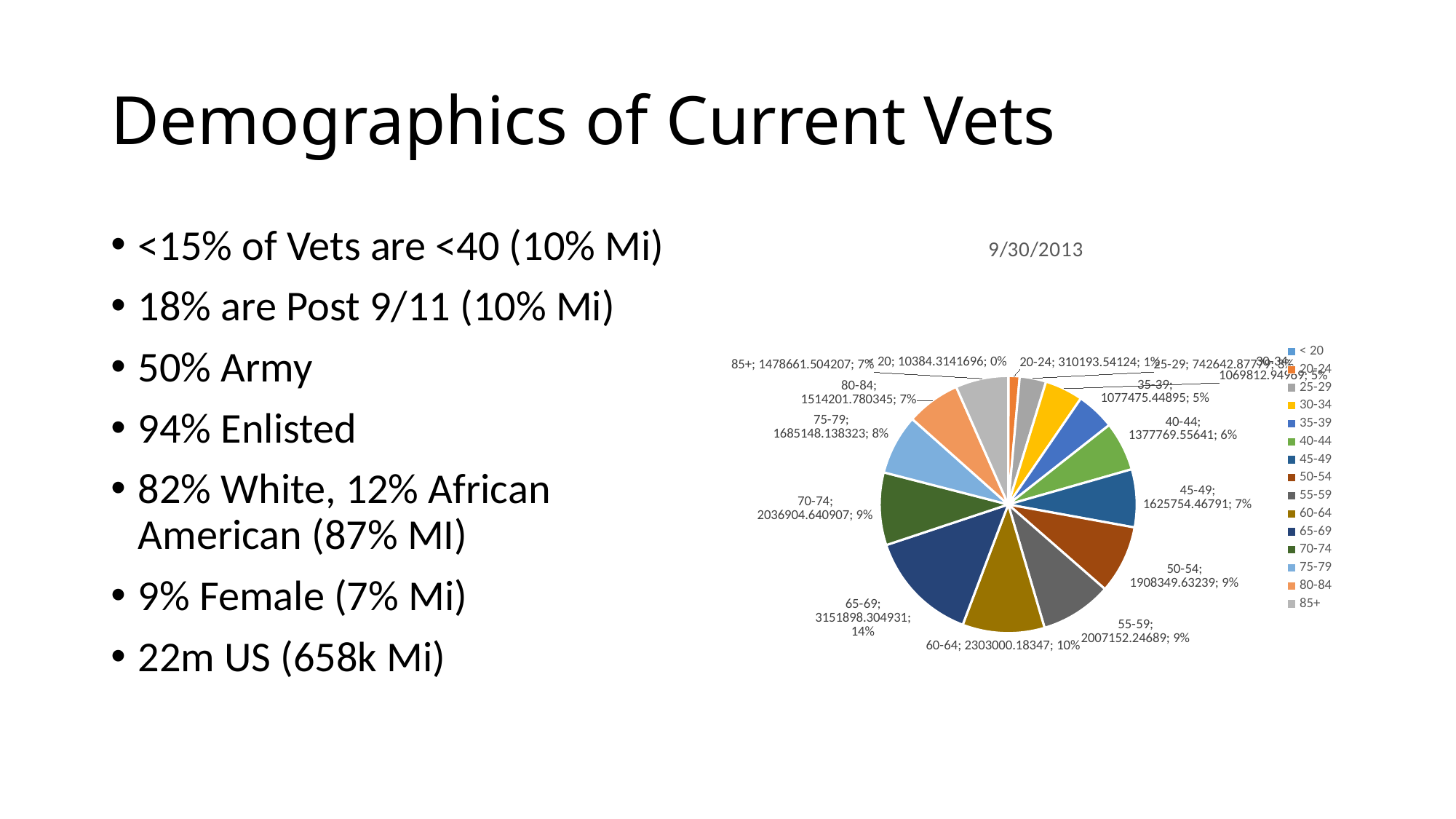
Which age group has the largest slice of the pie? 65-69 Which age group has the smallest slice of the pie? < 20 What value is shown for the 50-54 age group? 1908349.63239 Which slice is larger, 75-79 or 40-44? 75-79 What kind of chart is shown on the slide? pie chart What share of the pie does the 65-69 age group represent? 14% What share of the pie does the 20-24 age group represent? 1% What value is shown for the 70-74 age group? 2036904.640907 What share of the pie does the 60-64 age group represent? 10% How many categories does the chart's legend list? 15 What is the title of the chart? 9/30/2013